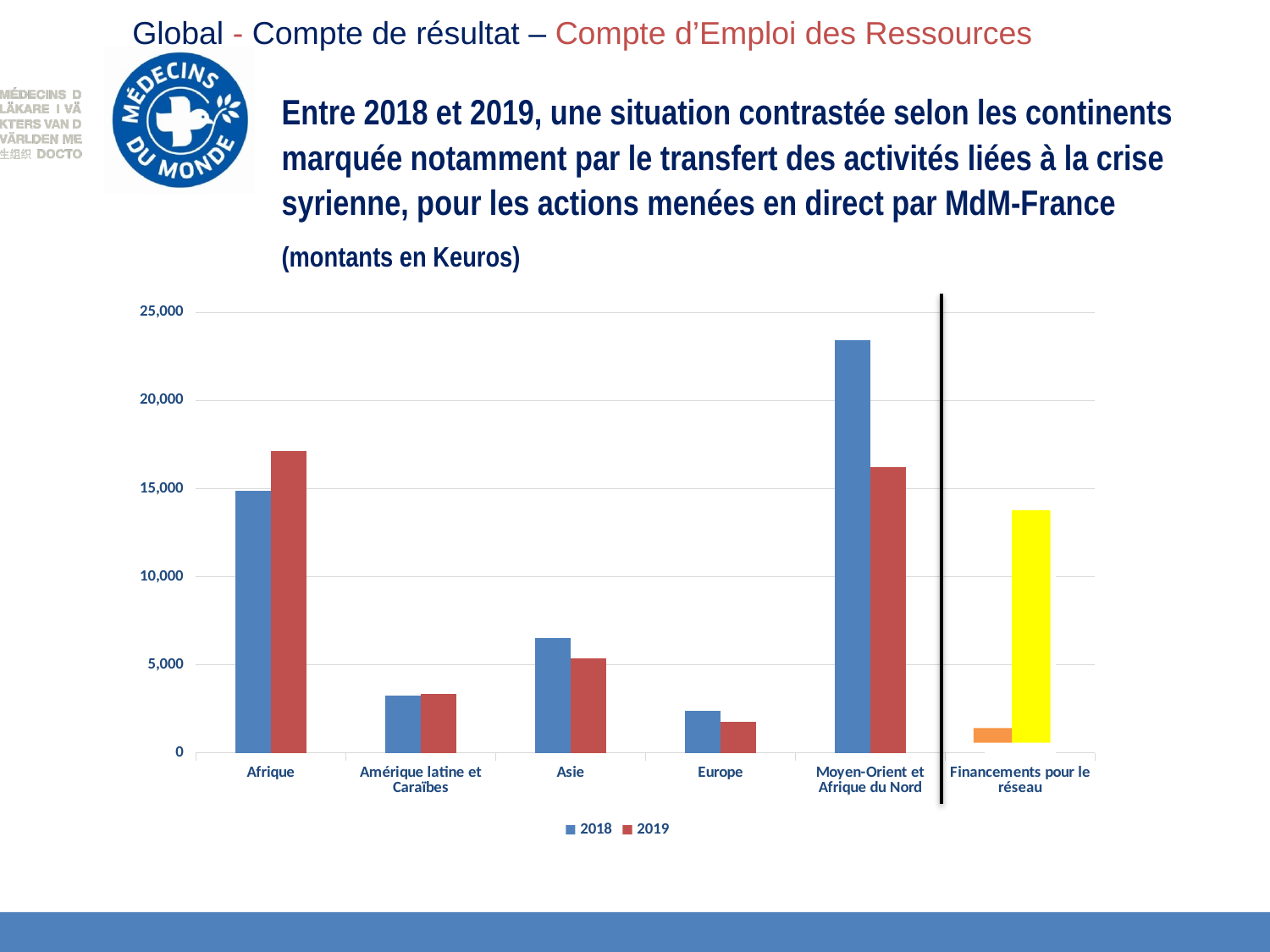
For Afrique, which year has the larger value, 2018 or 2019? 2019 Which category has the lowest value for 2018? Financements pour le réseau What kind of chart is shown on the slide? Bar chart For Moyen-Orient et Afrique du Nord, which year has the larger value, 2018 or 2019? 2018 Is the 2018 value for Moyen-Orient et Afrique du Nord greater or less than 20,000? greater How many series does the legend list? 2 Which category has the highest value for 2018? Moyen-Orient et Afrique du Nord Is the 2019 value for Europe greater or less than 5,000? less Is the 2019 value for Financements pour le réseau greater or less than 10,000? greater How many categories are shown on the x axis of the chart? 6 What are the two entries listed in the chart legend? 2018 and 2019